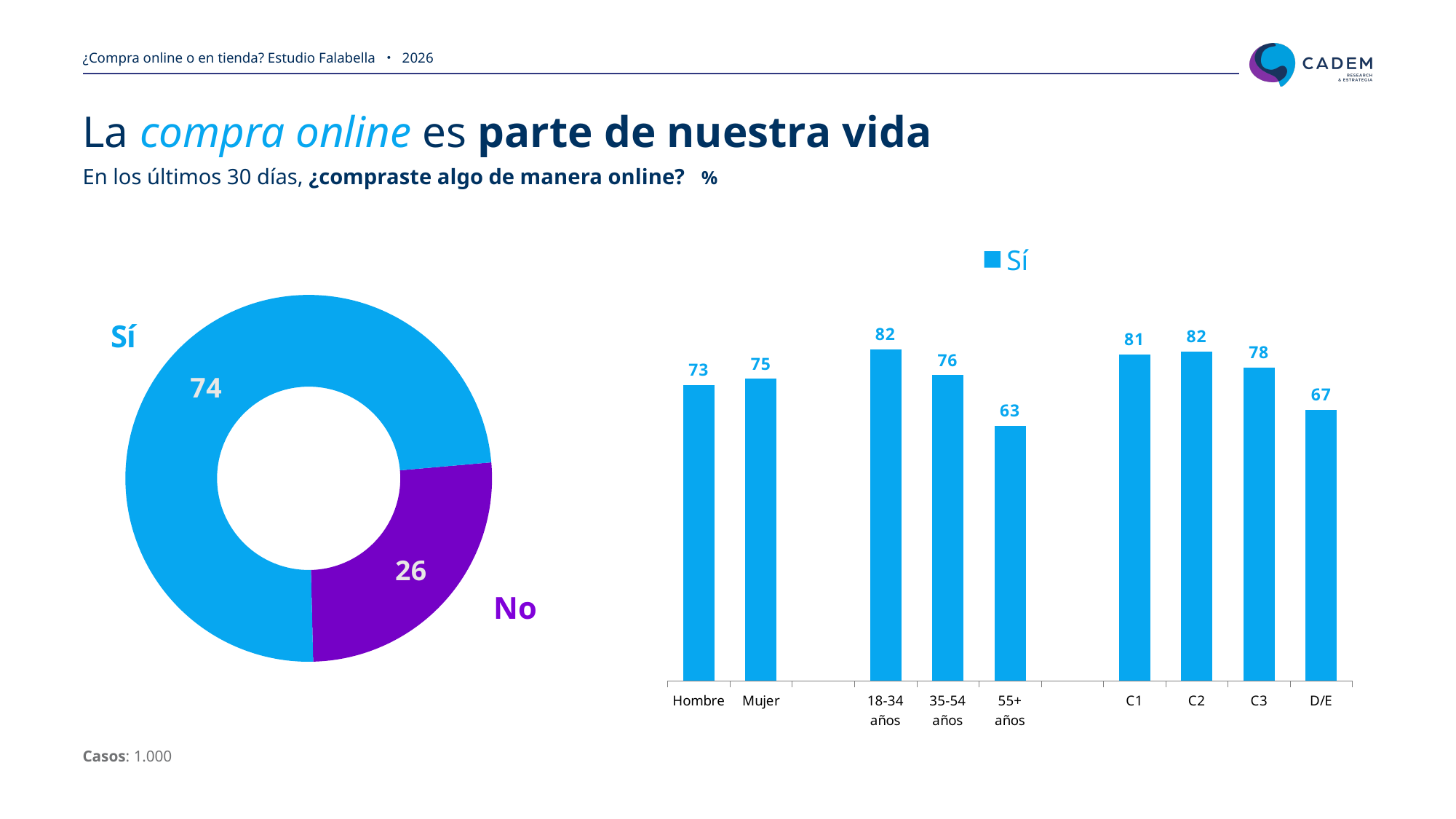
In the bar chart on the right, which category has the lowest value? 55+ años In the donut chart on the left, which slice is larger, Sí or No? Sí In the bar chart on the right, which is larger, the value for Hombre or the value for Mujer? Mujer In the donut chart on the left, what is the value for Sí? 74 What kind of chart is shown on the right side of the slide? Bar chart In the bar chart on the right, how many categories are shown on the x axis? 9 In the donut chart on the left, what is the value for No? 26 In the bar chart on the right, what is the value for 55+ años? 63 In the bar chart on the right, what is the value for Mujer? 75 In the bar chart on the right, what is the difference between the values for 18-34 años and 55+ años? 19 In the bar chart on the right, how many series does the legend list? 1 In the bar chart on the right, what is the value for D/E? 67